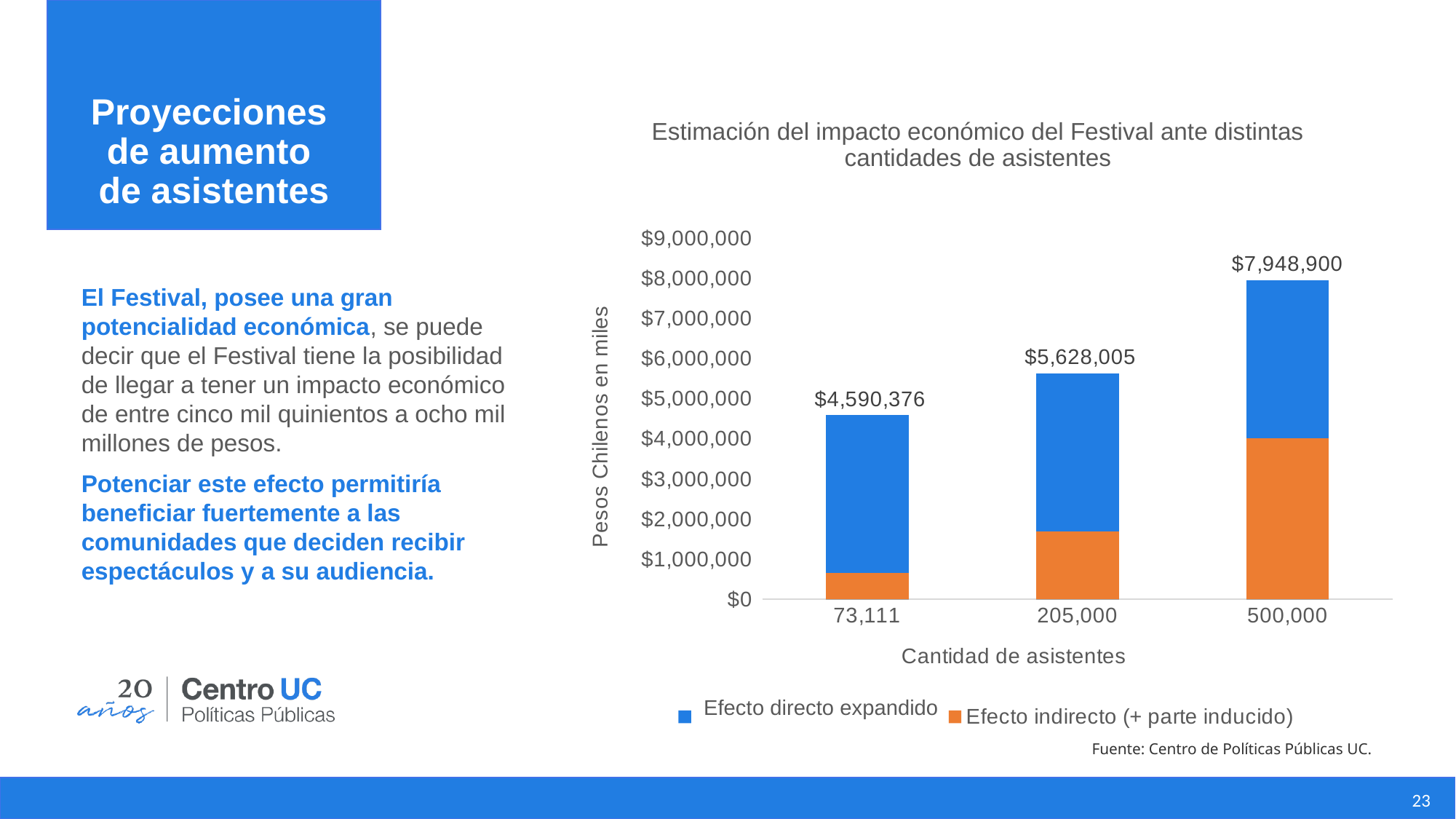
Which attendance level has the lowest estimated economic impact? 73,111 How many attendance levels are shown on the x axis? 3 Do the bar totals rise or fall as the number of asistentes increases? Rise How many series does the legend list? 2 Is the Efecto indirecto (+ parte inducido) value for 73,111 asistentes greater or less than $1,000,000? less Which is larger, the total for 205,000 asistentes or the total for 73,111 asistentes? 205,000 What kind of chart is shown on the slide? Stacked bar chart What is the total labelled on the bar for 500,000 asistentes? $7,948,900 What is the total labelled on the bar for 205,000 asistentes? $5,628,005 Which attendance level has the highest estimated economic impact? 500,000 What is the total labelled on the bar for 73,111 asistentes? $4,590,376 What is the difference between the total for 500,000 asistentes and the total for 205,000 asistentes? $2,320,895